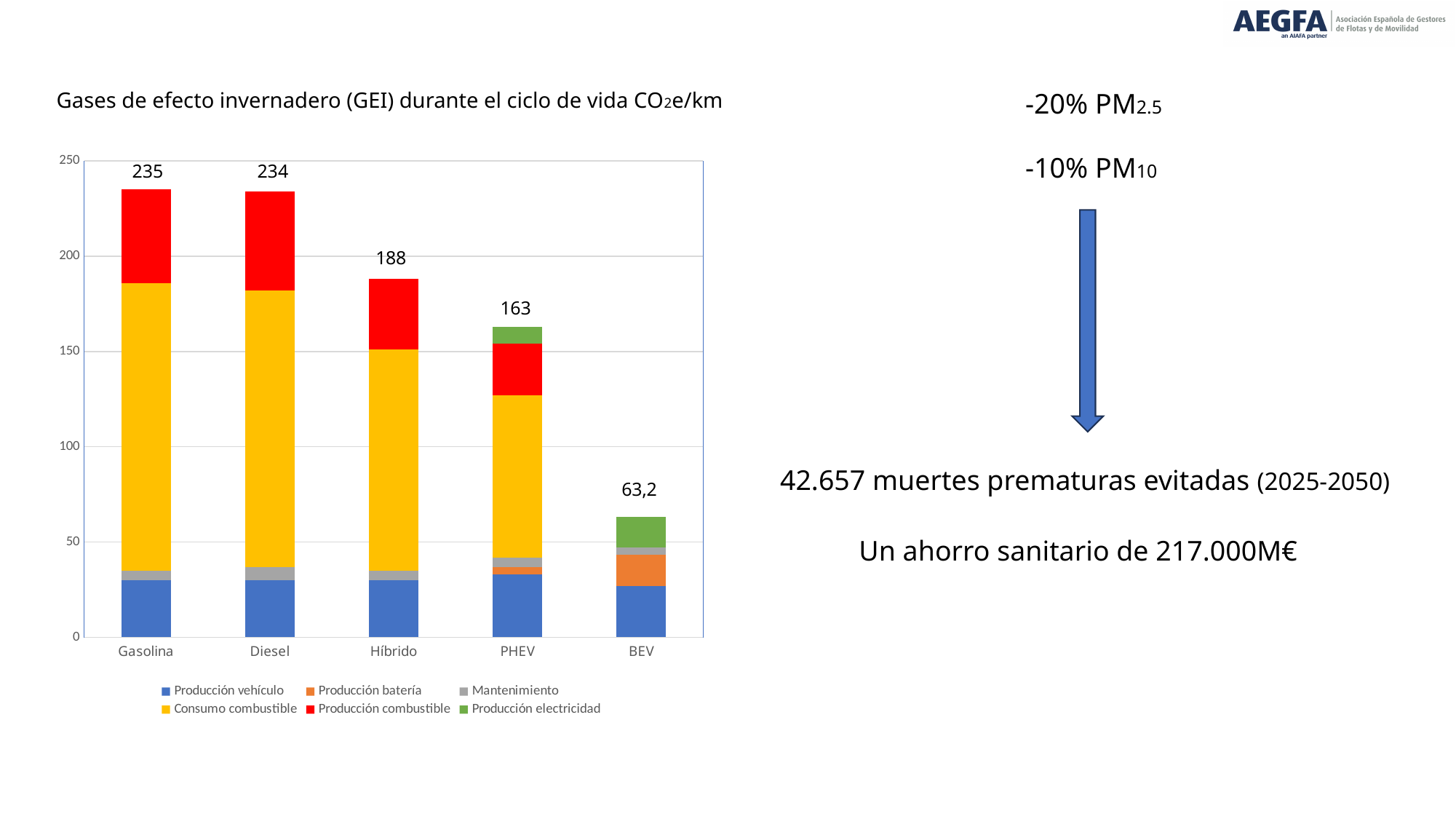
Which vehicle type has the highest total lifecycle GEI value? Gasolina What is the total value shown for PHEV? 163 What is the difference between the total values for Gasolina and Híbrido? 47 How many vehicle categories are shown on the x axis? 5 Which has a larger total value, Diesel or PHEV? Diesel What kind of chart is shown on the slide? Stacked bar chart How many series does the legend list? 6 Is the Producción vehículo segment for Gasolina greater or less than 50? less Which vehicle type has the lowest total lifecycle GEI value? BEV What is the total greenhouse gas value shown for Gasolina? 235 What is the total value labelled above the BEV bar? 63,2 What is the difference between the total values for Híbrido and PHEV? 25